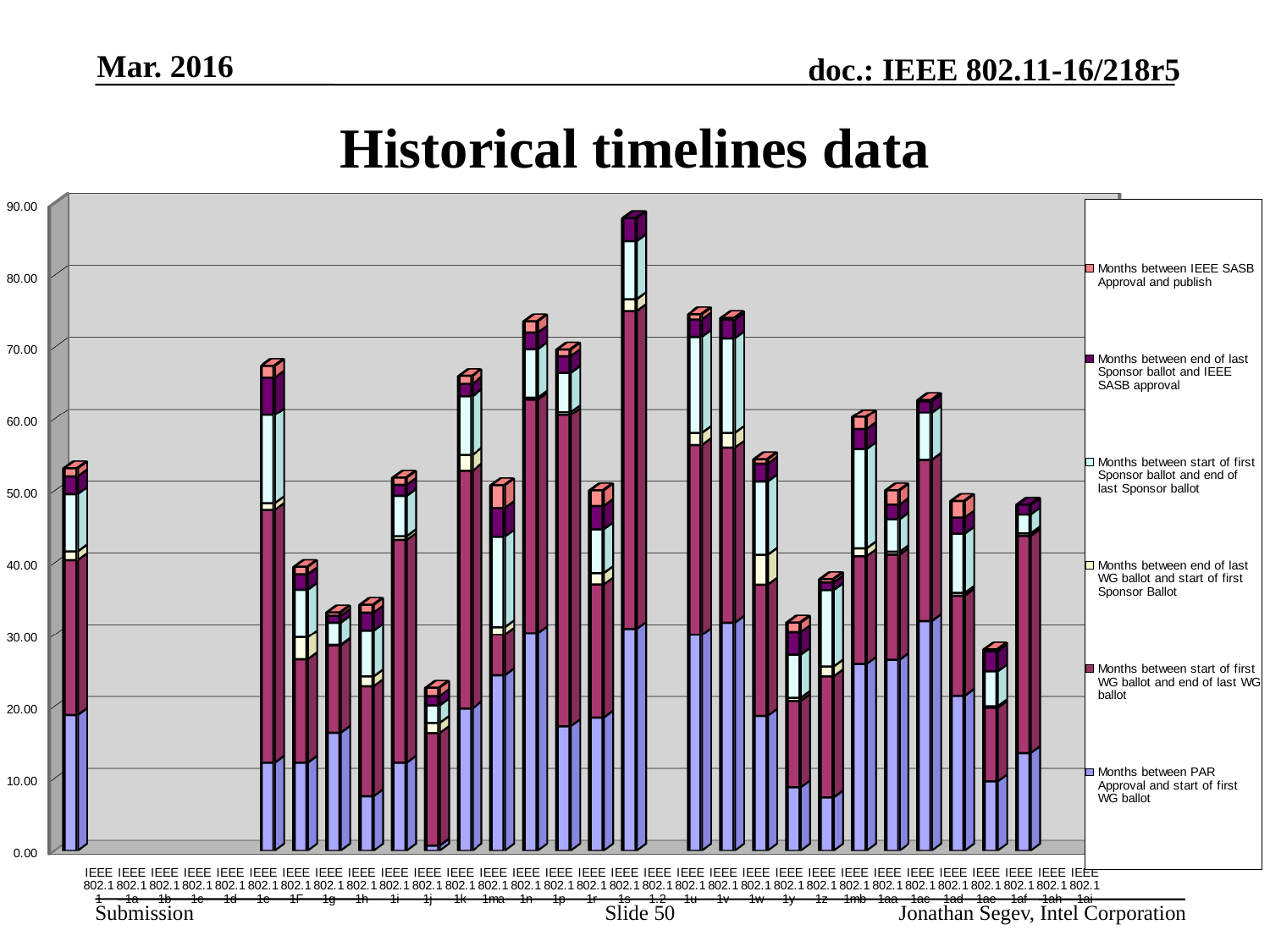
How many series does the legend list? 6 Which has the larger total stacked bar, IEEE 802.1 1u or IEEE 802.1 1w? IEEE 802.1 1u Which has the larger total stacked bar, IEEE 802.1 1e or IEEE 802.1 1F? IEEE 802.1 1e Is the total stacked value for IEEE 802.1 1s greater or less than 80.00? greater Is the total stacked value for IEEE 802.1 1e greater or less than 60.00? greater Is the total stacked value for IEEE 802.1 1j greater or less than 30.00? less Which category has the tallest stacked bar? IEEE 802.1 1s Which series is shown at the bottom of each stacked bar, according to the legend? Months between PAR Approval and start of first WG ballot What kind of chart is shown on the slide? Stacked bar chart What is the title of the chart? Historical timelines data Among the categories with plotted bars, which has the shortest stacked bar? IEEE 802.1 1j